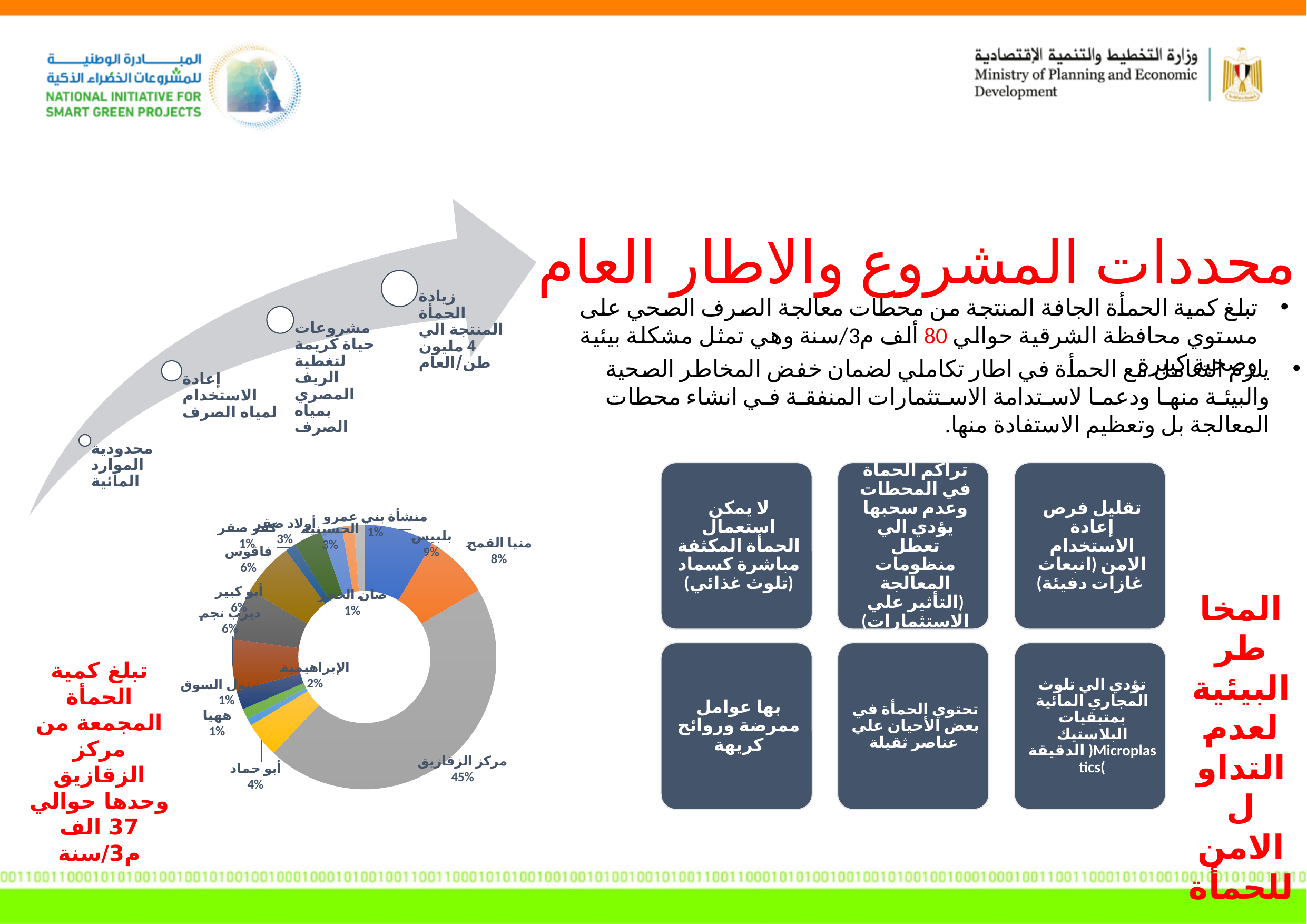
In the doughnut chart, what percentage is shown for منيا القمح? 8% What share of the doughnut chart does مركز الزقازيق represent? 45% In the doughnut chart, what percentage is shown for فاقوس? 6% In the doughnut chart, what is the difference between the percentages for مركز الزقازيق and بلبيس? 36% In the doughnut chart, what percentage is shown for أبو حماد? 4% What type of chart is shown on the slide? Doughnut (pie) chart What colour is the largest slice (مركز الزقازيق) in the doughnut chart? Grey In the doughnut chart, what percentage is shown for مركز الزقازيق? 45% In the doughnut chart, which is larger: بلبيس or منيا القمح? بلبيس Which category has the largest slice in the doughnut chart? مركز الزقازيق In the doughnut chart, what percentage is shown for بلبيس? 9% In the doughnut chart, what percentage is shown for الإبراهيمية? 2%